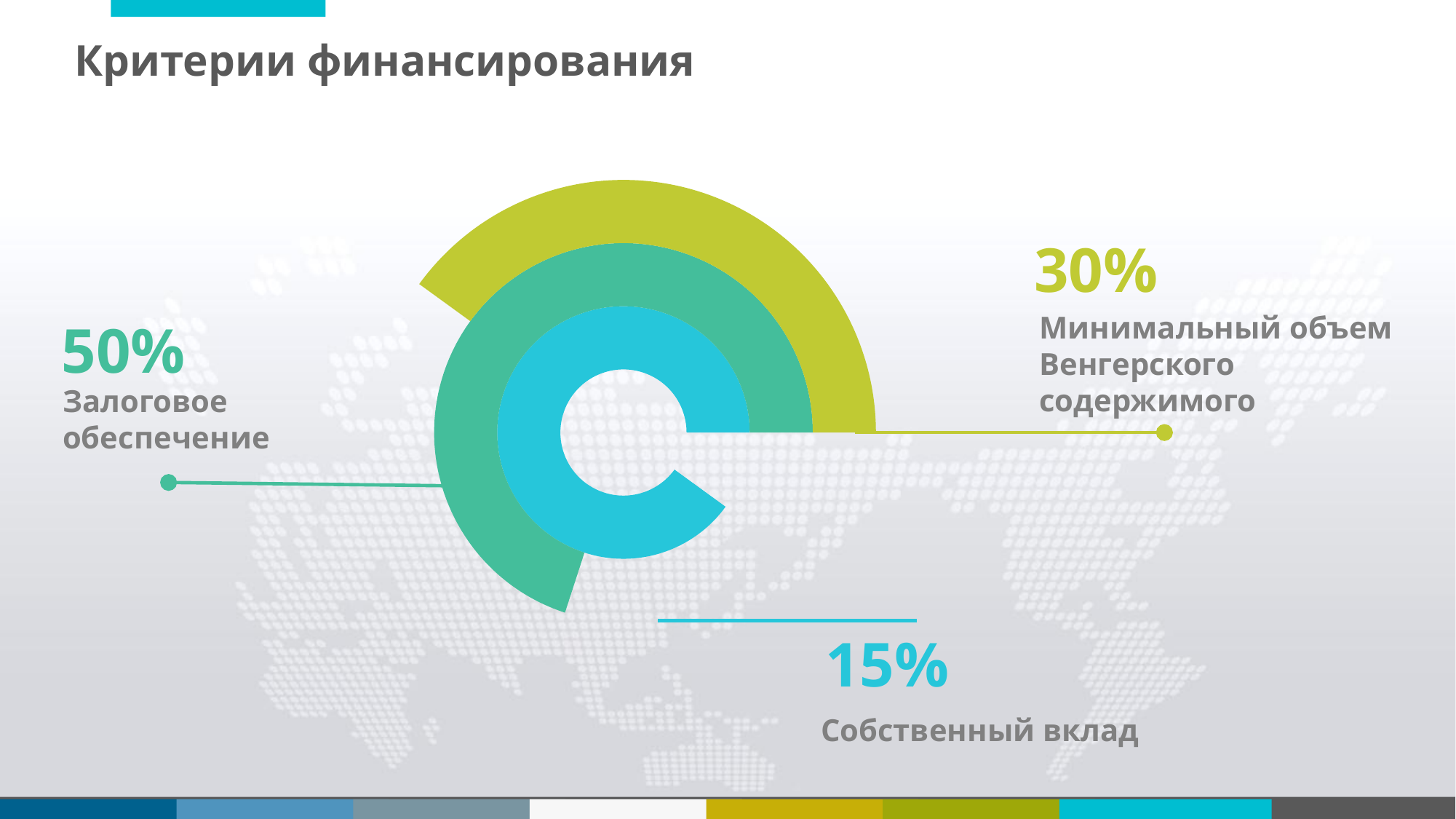
Which criterion has the highest percentage? Залоговое обеспечение What value is shown for Минимальный объем Венгерского содержимого? 30% How many criteria are shown in the chart? 3 What value is shown for Собственный вклад? 15% What value is shown for Залоговое обеспечение? 50% Which is larger, the value for Минимальный объем Венгерского содержимого or the value for Собственный вклад? Минимальный объем Венгерского содержимого What is the difference between the values for Залоговое обеспечение and Минимальный объем Венгерского содержимого? 20% What is the title of the slide? Критерии финансирования Which criterion has the lowest percentage? Собственный вклад What is the difference between the values for Залоговое обеспечение and Собственный вклад? 35% What colour is the arc representing Собственный вклад? Cyan (light blue)